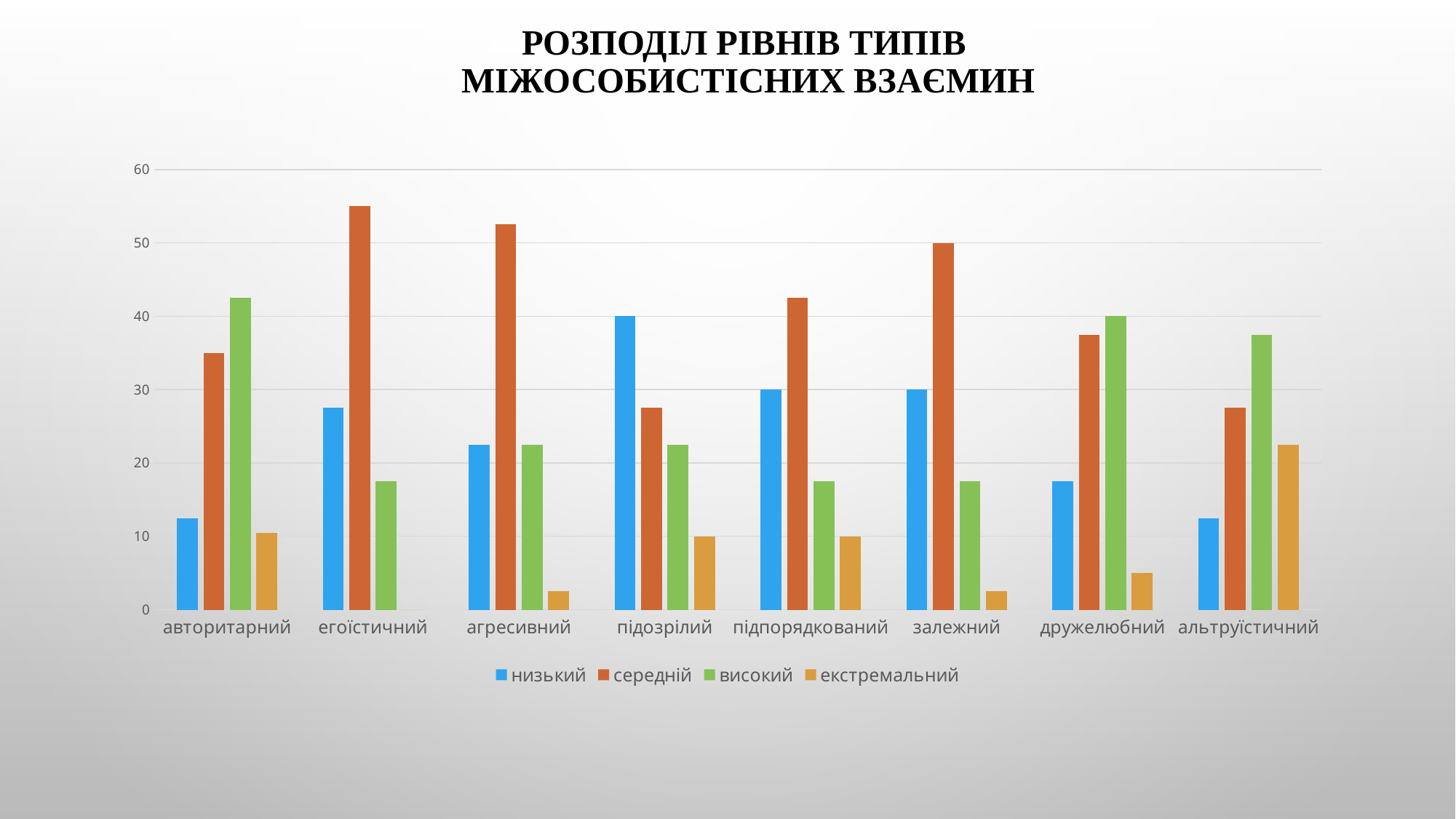
Which category has the highest value for the низький series? підозрілий How many categories are shown on the x axis? 8 Which is larger in the агресивний category: середній or високий? середній What kind of chart is shown on the slide? bar chart Which category has the lowest value for the екстремальний series, егоїстичний or альтруїстичний? егоїстичний What colour represents the високий series in the legend? green How many series does the legend list? 4 Is the value for високий in the авторитарний category greater or less than 40? greater Is the value for середній in the егоїстичний category greater or less than 50? greater Which is larger in the підозрілий category: низький or середній? низький Is the value for екстремальний in the альтруїстичний category greater or less than 20? greater Which category has the highest value for the середній series? егоїстичний